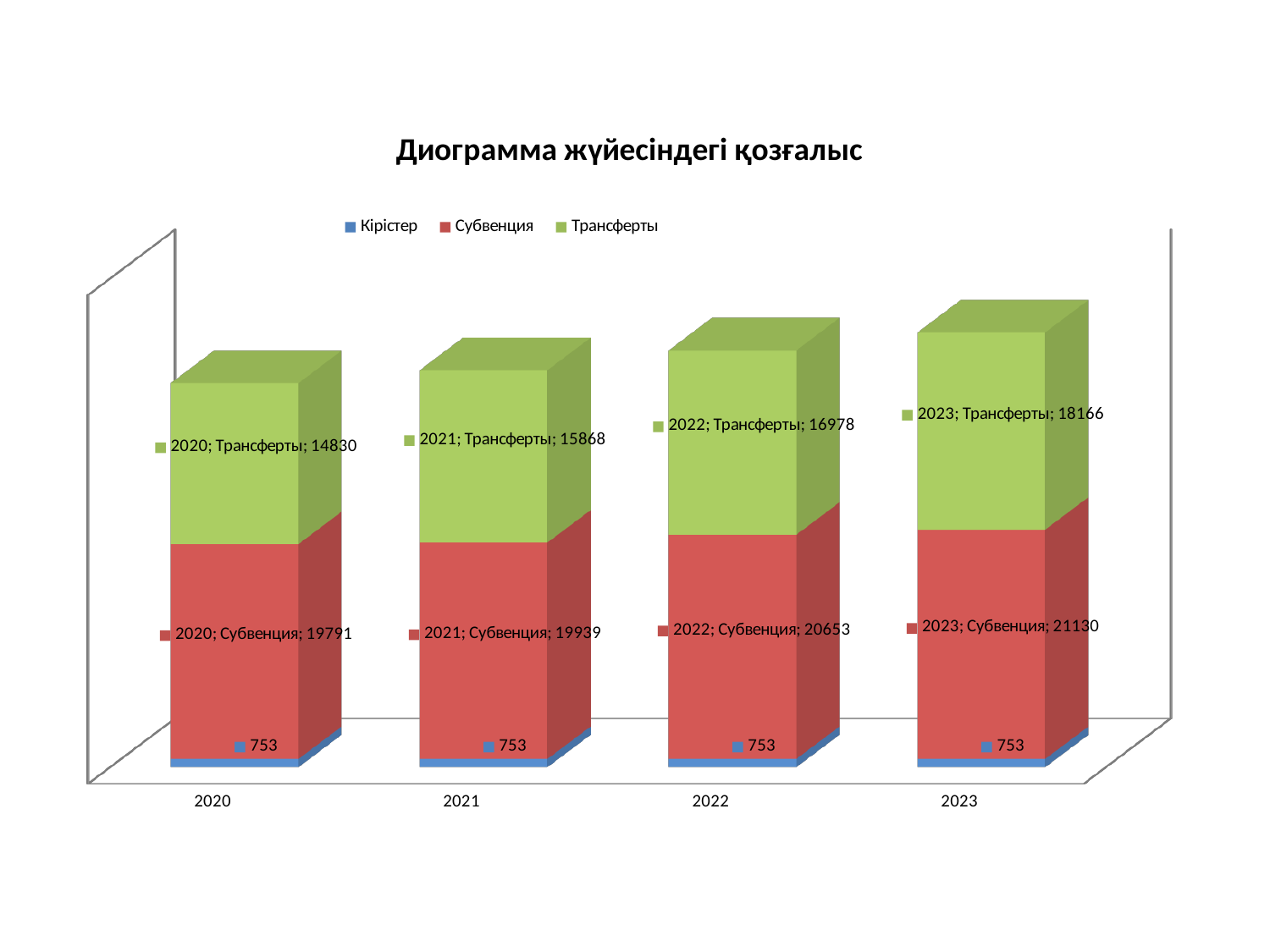
What is the difference between Трансферты in 2023 and in 2020? 3336 What is the value of Трансферты for 2022? 16978 What is the value of Кірістер for 2023? 753 Which is larger: Субвенция in 2021 or Субвенция in 2022? Субвенция in 2022 In which year is Субвенция lowest? 2020 What is the total of the stacked bar for 2023? 40049 How many series does the legend list? 3 What is the value of Субвенция for 2020? 19791 What type of chart is shown on the slide? Stacked bar chart What is the title of the chart? Диограмма жүйесіндегі қозғалыс How many years (categories) are shown on the x axis? 4 In which year is Трансферты highest? 2023